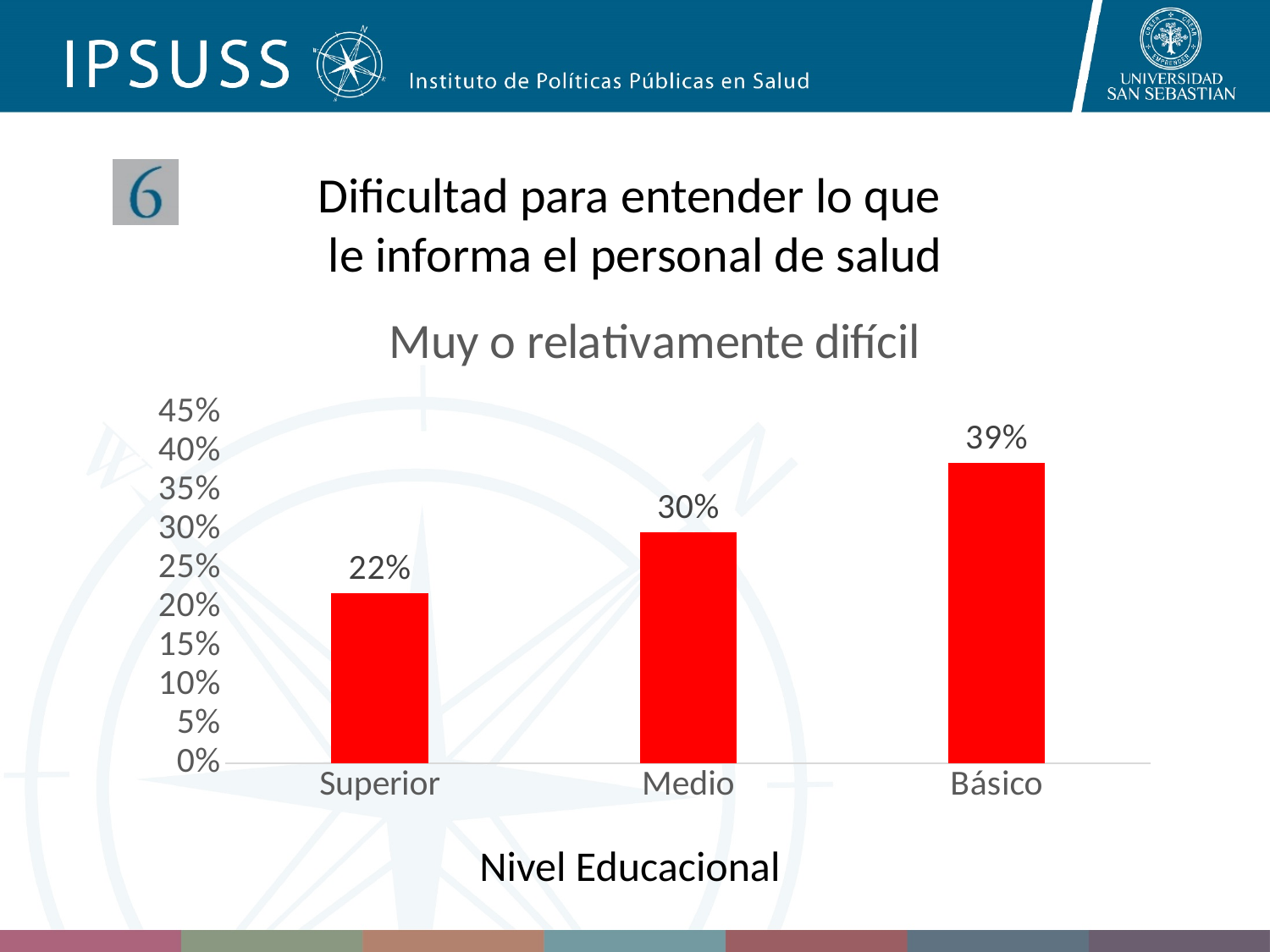
Do the values rise or fall from Superior to Básico along the x axis? Rise Which is larger, the value for Medio or the value for Básico? Básico Which educational level has the lowest value? Superior What is the value for Básico? 39% How many categories are shown on the x axis? 3 What is the value for Medio? 30% What is the difference between the values for Básico and Superior? 17% Which educational level has the highest value? Básico What is the value for Superior? 22% What kind of chart is shown on the slide? Bar chart What is the difference between the values for Medio and Superior? 8% What is the title of the chart? Muy o relativamente difícil